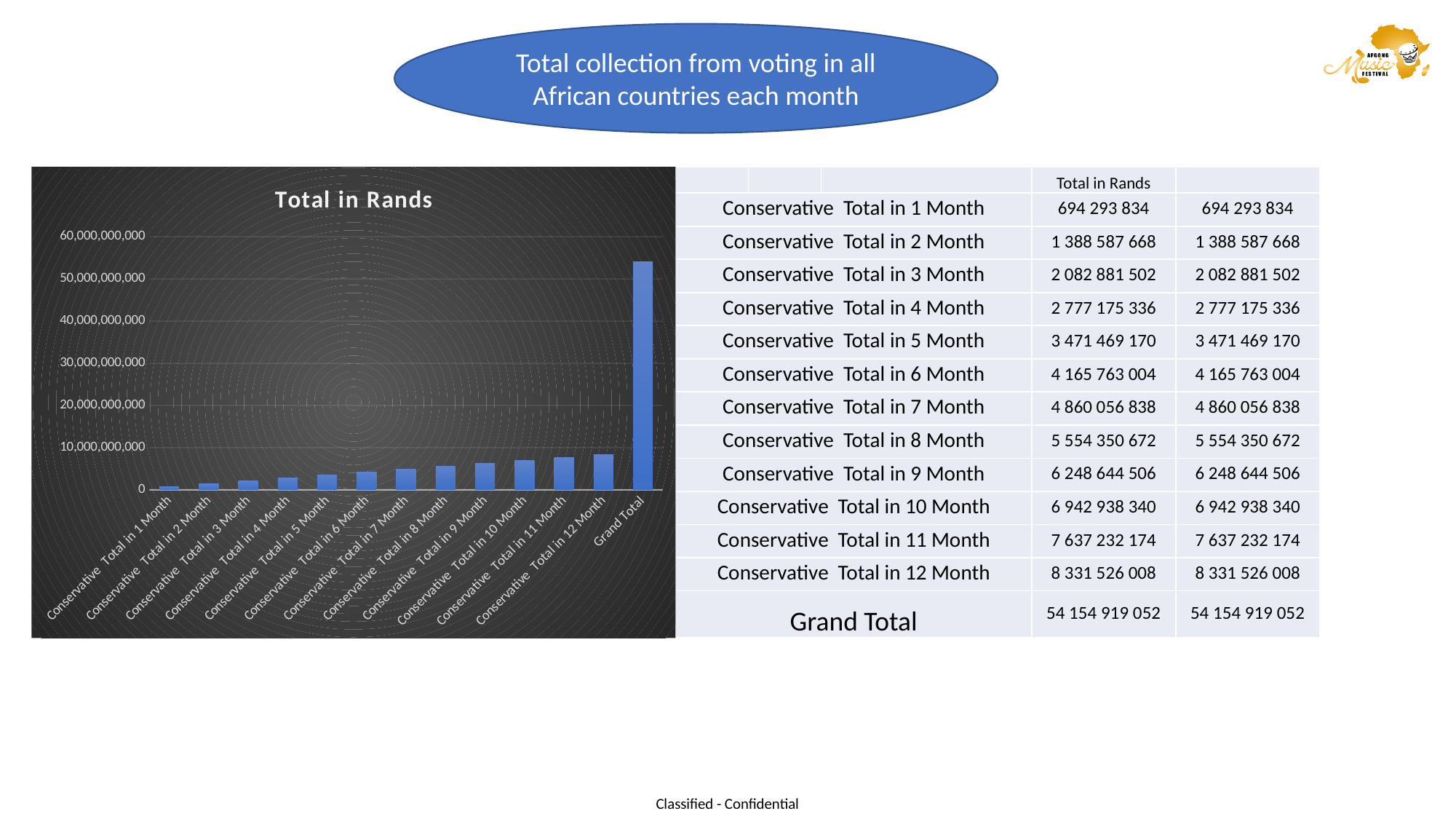
Which category has the tallest bar in the chart? Grand Total What is the title of the chart? Total in Rands How many bars does the chart have? 13 According to the table on the slide, what is the Total in Rands for Conservative Total in 6 Month? 4 165 763 004 According to the table on the slide, what is the Grand Total in Rands? 54 154 919 052 Is the value for Conservative Total in 12 Month greater or less than 10,000,000,000? less Which category has the shortest bar in the chart? Conservative Total in 1 Month What kind of chart is shown on the slide? bar chart Is the value for Grand Total greater or less than 50,000,000,000? greater Using the values in the table, what is the difference between Conservative Total in 2 Month and Conservative Total in 1 Month? 694 293 834 Do the bars rise or fall from Conservative Total in 1 Month to Conservative Total in 12 Month? rise Which is larger, the bar for Conservative Total in 3 Month or the bar for Conservative Total in 9 Month? Conservative Total in 9 Month